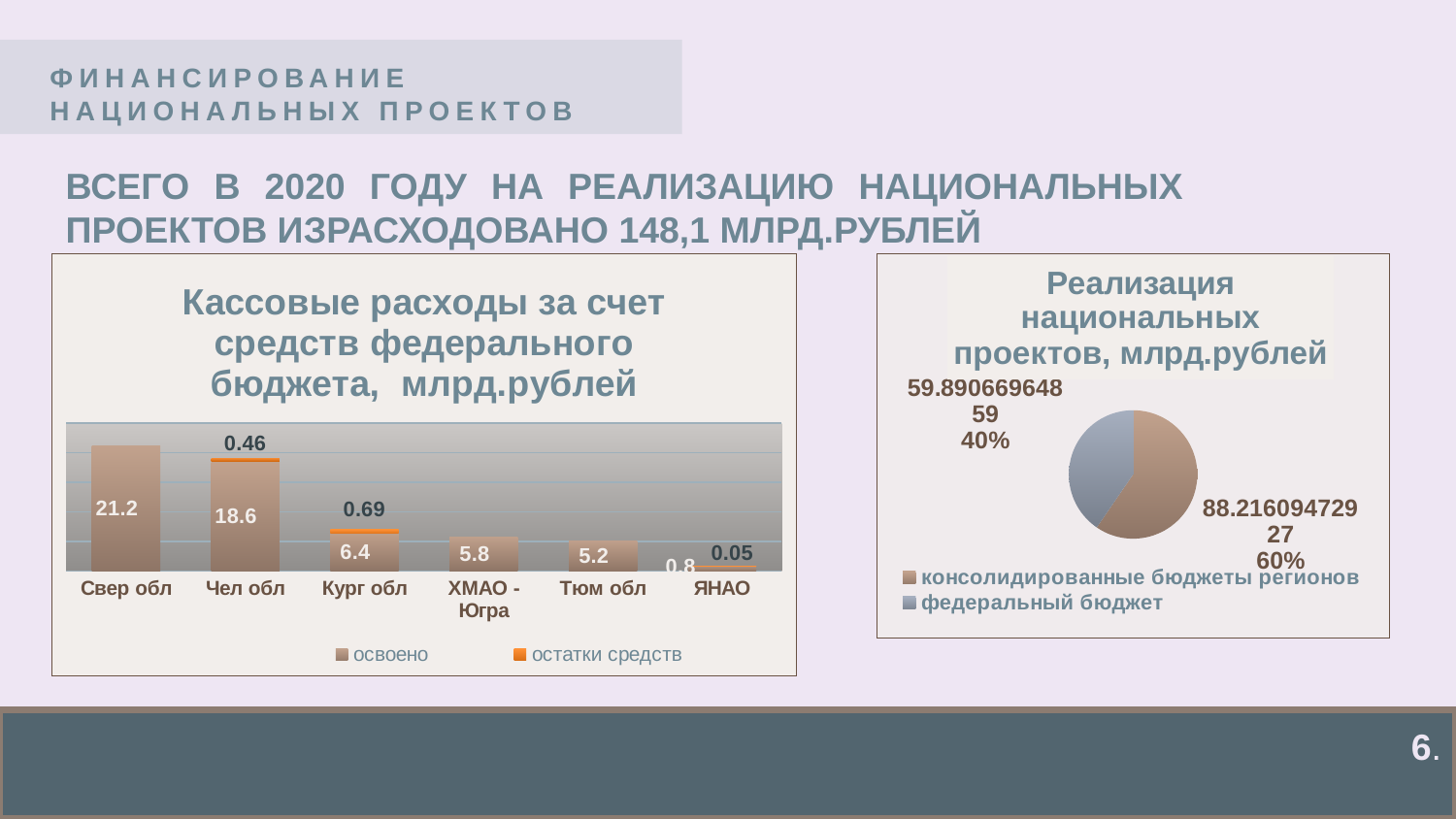
In the left chart (Кассовые расходы), what is the остатки средств value for Кург обл? 0.69 In the left chart (Кассовые расходы), what is the освоено value for Свер обл? 21.2 In the left chart (Кассовые расходы), how many series does the legend list? 2 What kind of chart is the left chart titled "Кассовые расходы за счет средств федерального бюджета, млрд.рублей"? bar chart In the left chart (Кассовые расходы), do the освоено values rise or fall from left to right along the x axis? fall What kind of chart is the right chart titled "Реализация национальных проектов, млрд.рублей"? pie chart In the left chart (Кассовые расходы), what is the total of the stacked bar for Чел обл (освоено plus остатки средств)? 19.06 In the left chart (Кассовые расходы), what is the difference between the освоено values for Свер обл and Чел обл? 2.6 In the right pie chart (Реализация национальных проектов), what share does федеральный бюджет have? 40% In the left chart (Кассовые расходы), which region has the highest освоено value? Свер обл In the left chart (Кассовые расходы), how many regions are shown on the x axis? 6 In the left chart (Кассовые расходы), which region has the lowest освоено value? ЯНАО